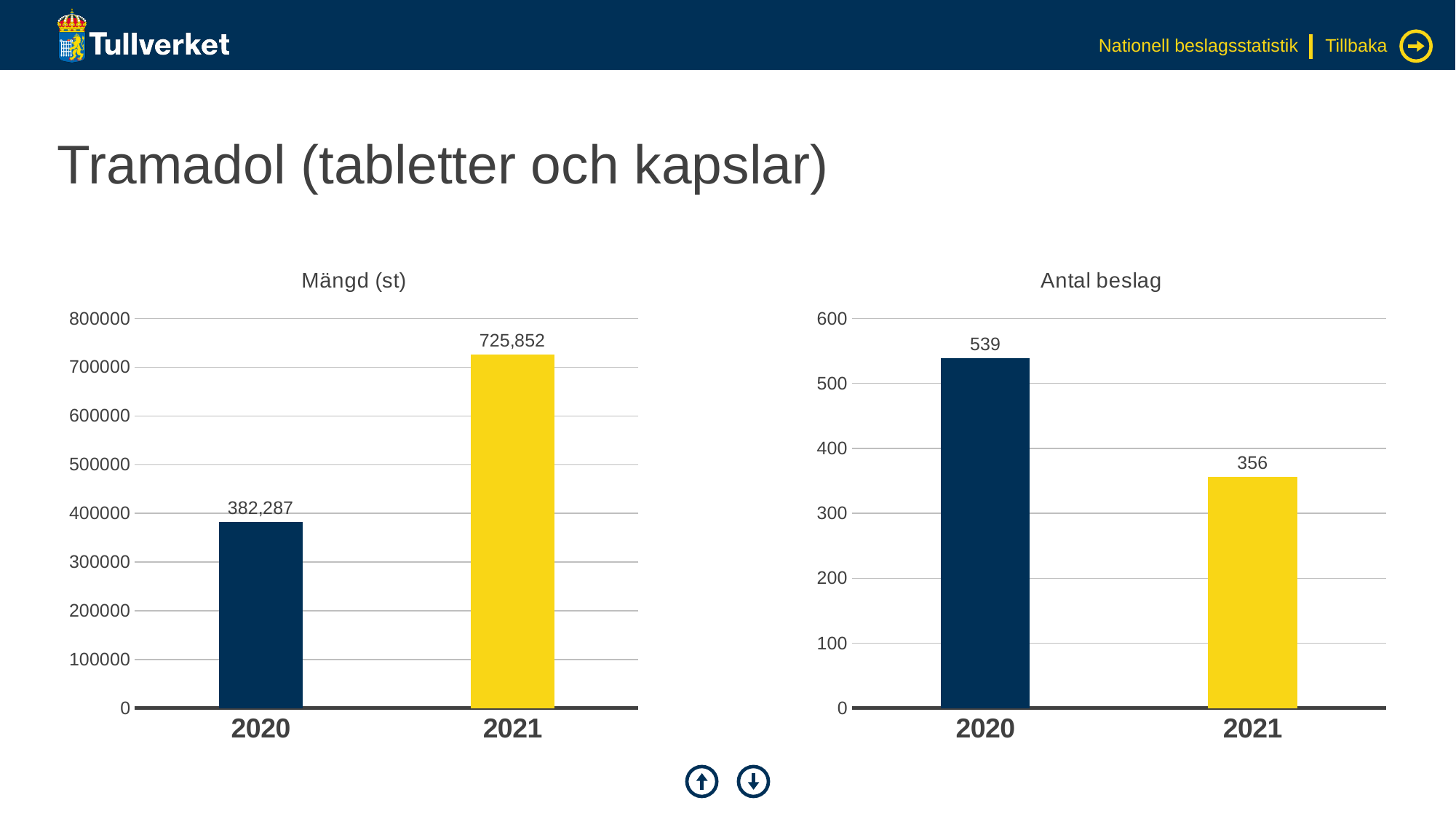
In the "Mängd (st)" chart, what is the value for 2020? 382,287 In the "Antal beslag" chart, what is the value for 2020? 539 In the "Antal beslag" chart, do the values rise or fall from 2020 to 2021? fall How many categories are shown on the x axis of the "Mängd (st)" chart? 2 In the "Mängd (st)" chart, what is the difference between the 2021 and 2020 values? 343,565 What kind of chart is the "Antal beslag" chart? bar chart In the "Antal beslag" chart, which year has the lowest value? 2021 In the "Antal beslag" chart, is the value for 2020 greater or less than 500? greater In the "Antal beslag" chart, what is the difference between the 2020 and 2021 values? 183 In the "Mängd (st)" chart, which year has the highest value? 2021 In the "Mängd (st)" chart, what is the value for 2021? 725,852 In the "Antal beslag" chart, what is the value for 2021? 356